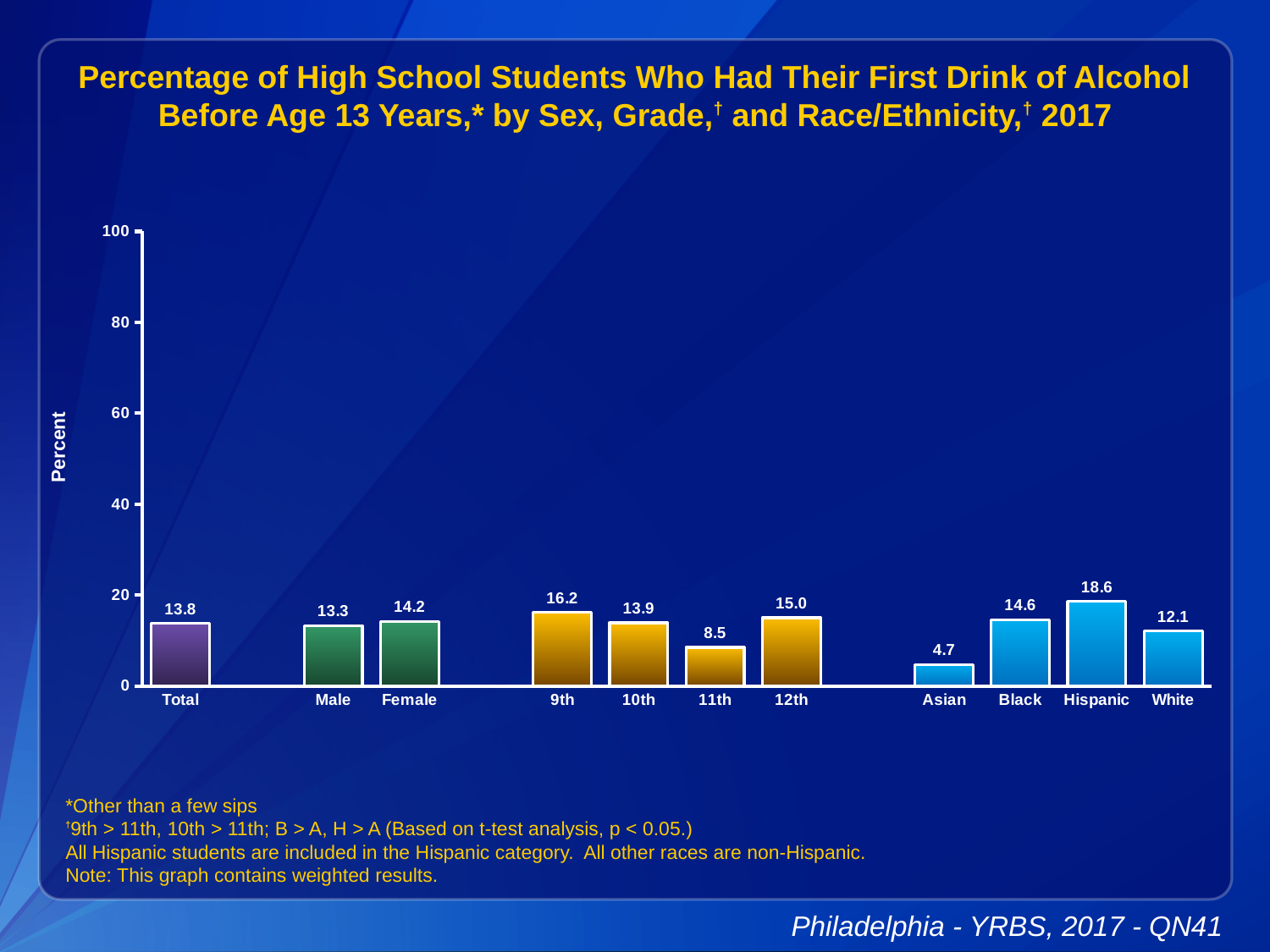
How many bars are shown in the chart? 11 What is the difference between the Female and Male values? 0.9 Which category has the highest value? Hispanic Which category has the lowest value? Asian What is the difference between the 9th grade and 11th grade values? 7.7 Which is larger, the value for Black or the value for White? Black What is the value for 11th grade? 8.5 What kind of chart is shown on the slide? bar chart What is the label on the vertical axis? Percent What percentage of Hispanic students had their first drink of alcohol before age 13? 18.6 Is the value for 12th grade greater or less than 20? less What is the value for Total? 13.8